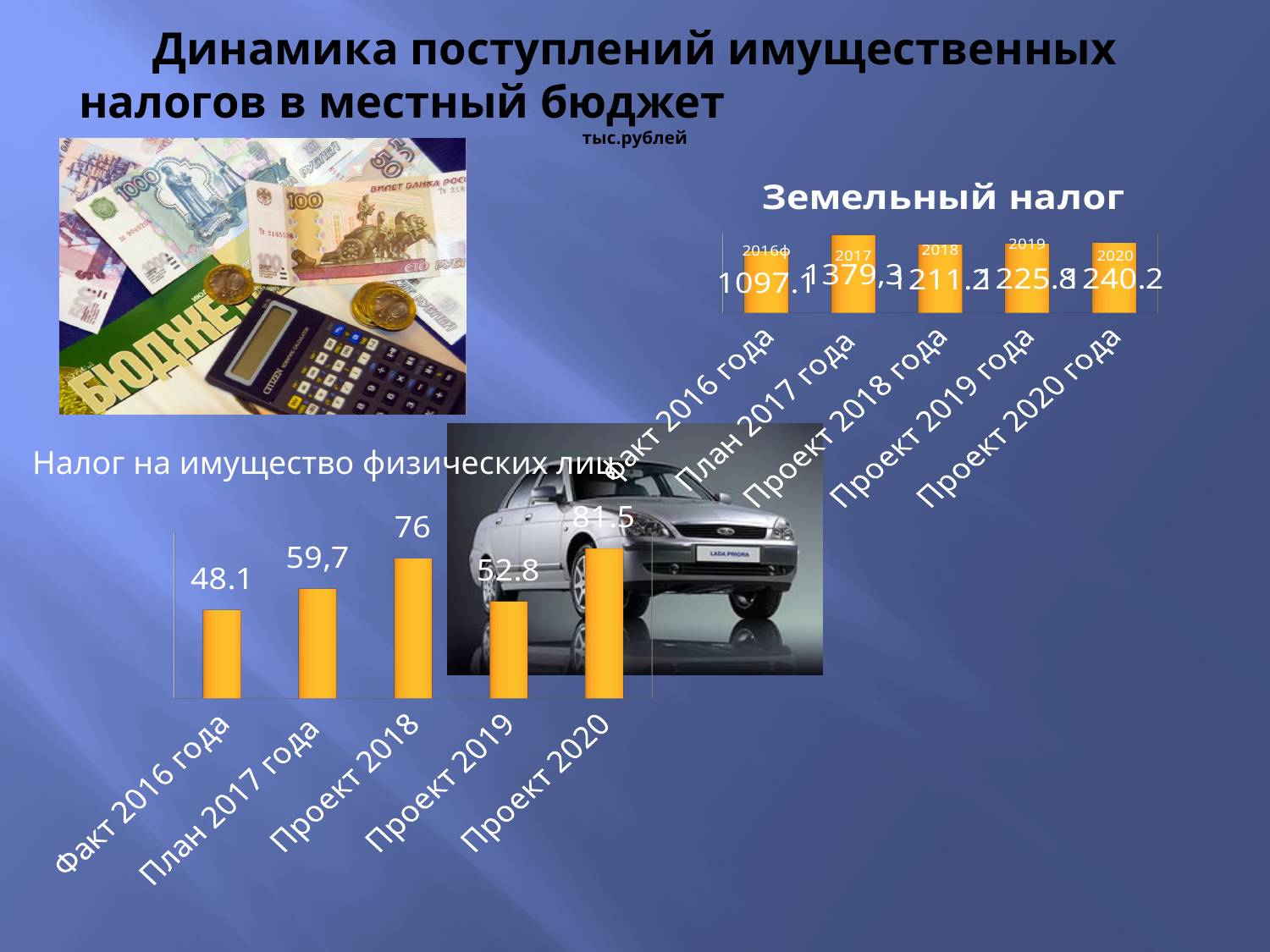
On the 'Налог на имущество физических лиц' chart, what is the value for Проект 2020? 81.5 What kind of chart is the 'Земельный налог' chart? bar chart On the 'Налог на имущество физических лиц' chart, what is the difference between Проект 2020 and Проект 2019? 28.7 On the 'Земельный налог' chart, which category has the lowest value? Факт 2016 года On the 'Налог на имущество физических лиц' chart, which category has the highest value? Проект 2020 On the 'Налог на имущество физических лиц' chart, what is the value for Проект 2018? 76 On the 'Земельный налог' chart, what is the value for План 2017 года? 1379,3 On the 'Налог на имущество физических лиц' chart, which is larger: Проект 2018 or Проект 2019? Проект 2018 On the 'Налог на имущество физических лиц' chart, what is the value for Факт 2016 года? 48.1 On the 'Налог на имущество физических лиц' chart, which category has the lowest value? Факт 2016 года How many categories are shown on the 'Налог на имущество физических лиц' chart? 5 On the 'Земельный налог' chart, what is the value for Проект 2020 года? 1240.2